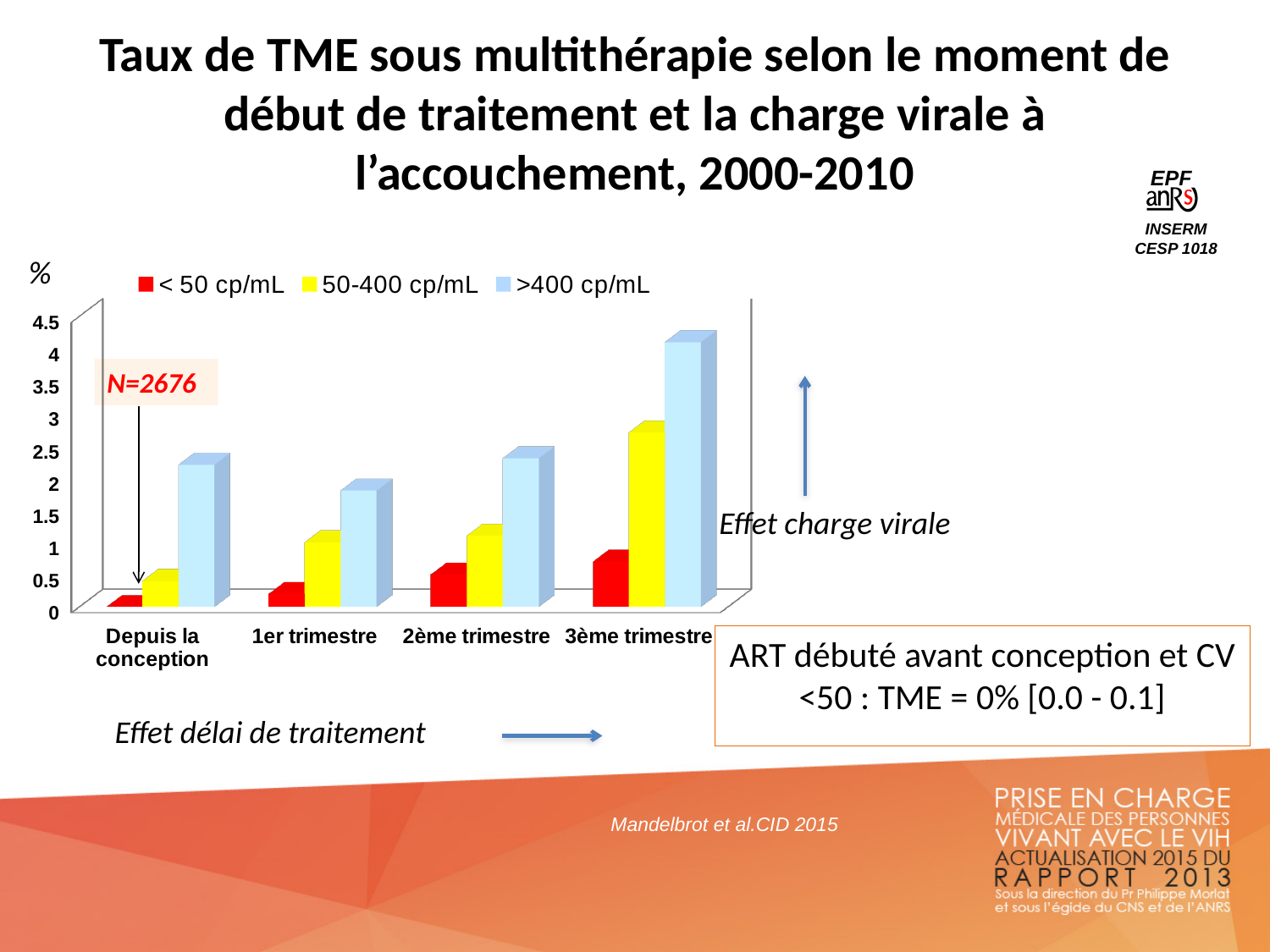
What kind of chart is shown on the slide? bar chart Which category has the highest value for the >400 cp/mL series? 3ème trimestre Is the value for < 50 cp/mL in the Depuis la conception category greater or less than 0.5? less Which is larger for the 50-400 cp/mL series: 2ème trimestre or 3ème trimestre? 3ème trimestre Is the value for >400 cp/mL in the 1er trimestre category greater or less than 1.5? greater What sample size (N) is annotated on the chart? N=2676 How many series does the legend list? 3 Is the value for 50-400 cp/mL in the 3ème trimestre category greater or less than 2.5? greater How many categories are shown on the x axis? 4 Which category has the lowest value for the < 50 cp/mL series? Depuis la conception Do the values for the < 50 cp/mL series rise or fall from Depuis la conception to 3ème trimestre? rise